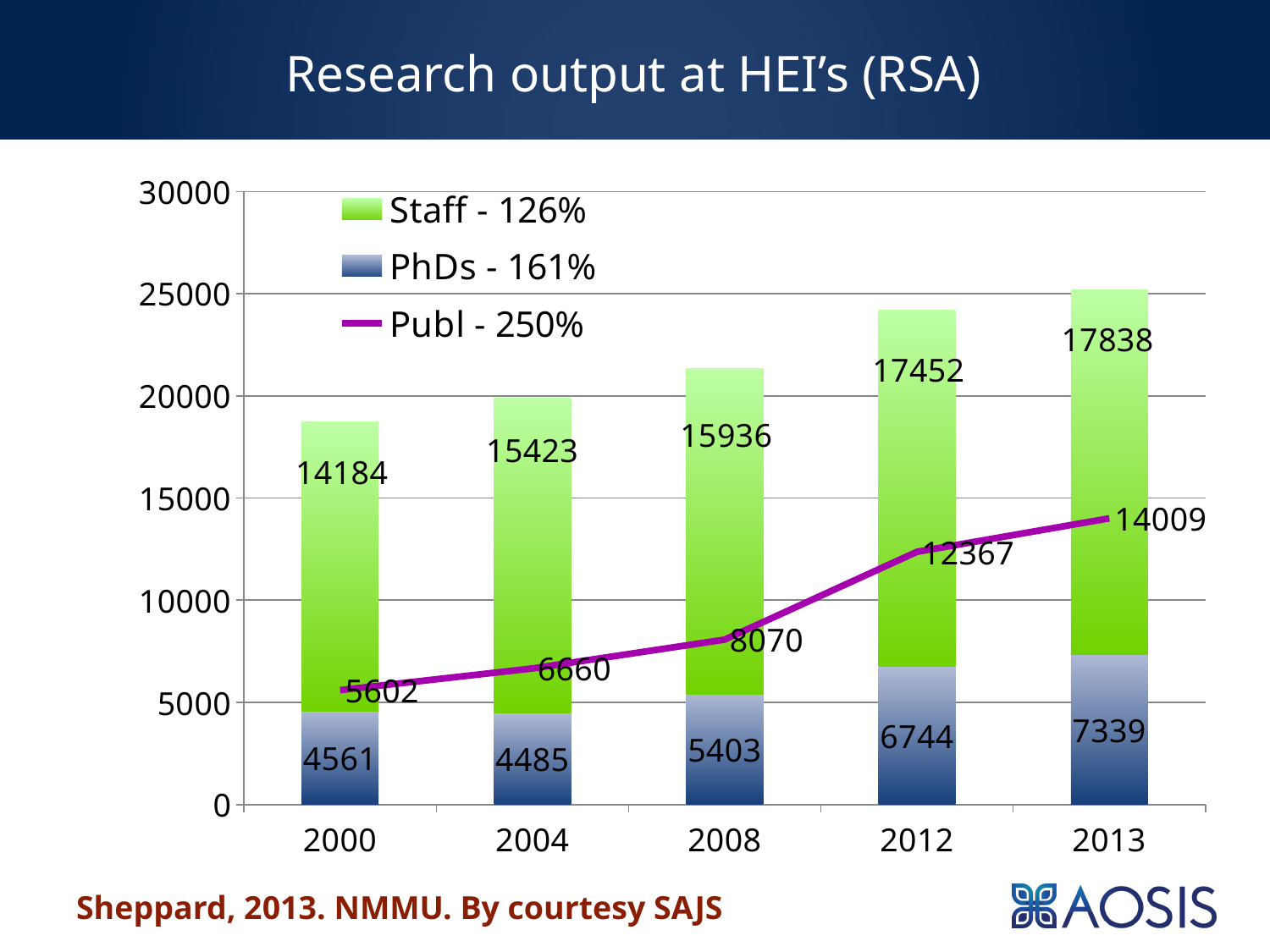
Which is larger, the Publ value for 2012 or the PhDs value for 2012? Publ value for 2012 What is the Staff value for 2008? 15936 How many series does the legend list? 3 What is the difference between the Staff values for 2013 and 2000? 3654 How many years are shown on the x axis? 5 Does the Publ line rise or fall from 2000 to 2013? rise What is the Publ value for 2004? 6660 In which year is the Publ value highest? 2013 What is the total of the stacked bar for 2013 (Staff plus PhDs)? 25177 What is the PhDs value for 2012? 6744 What is the title of the chart? Research output at HEI's (RSA) In which year is the PhDs value lowest? 2004